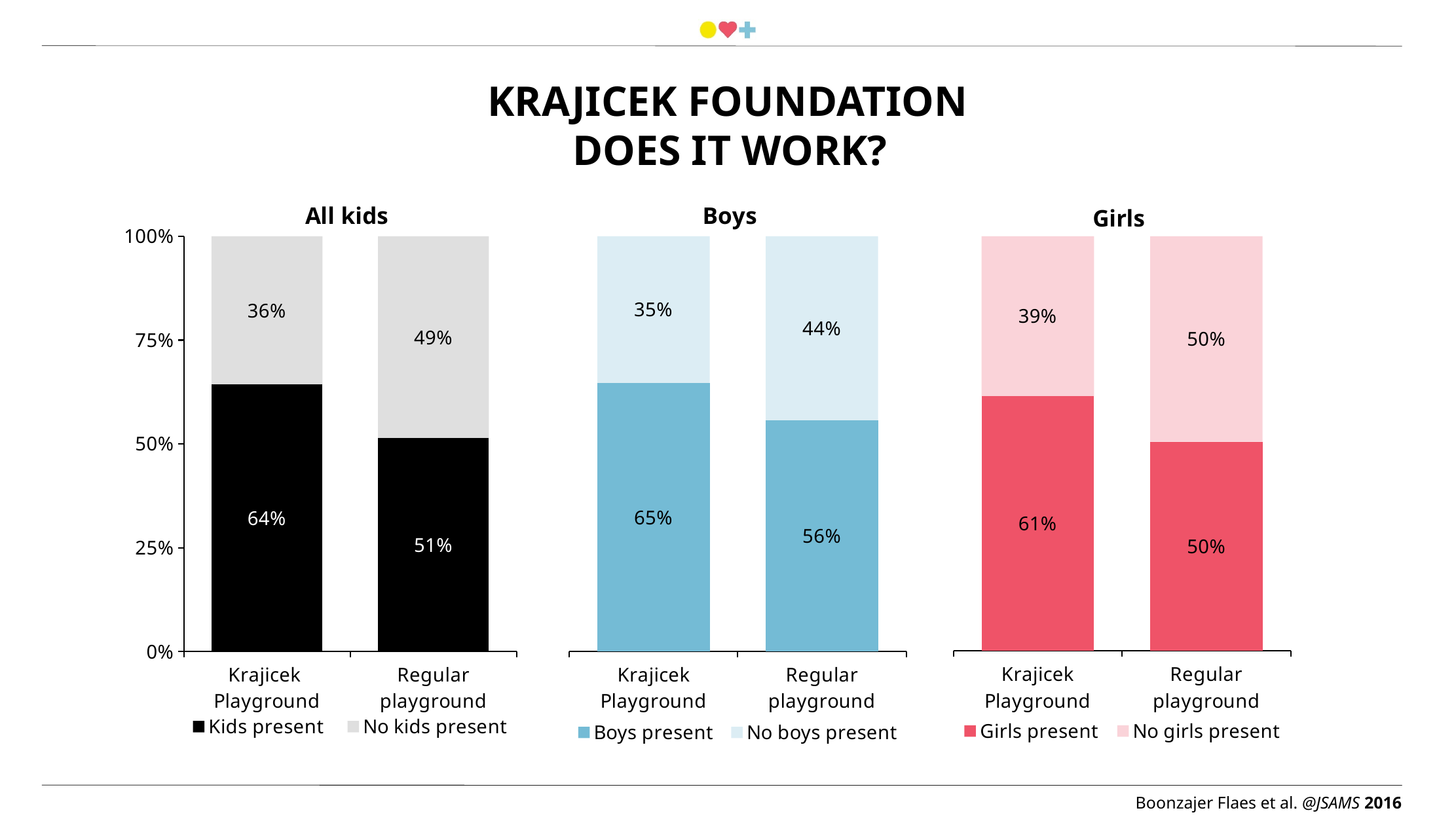
What kind of chart is the 'All kids' chart? Stacked bar chart In the 'All kids' chart, what is the difference between 'Kids present' at the Krajicek Playground and at the Regular playground? 13% In the 'Boys' chart, what is the difference between 'No boys present' at the Regular playground and at the Krajicek Playground? 9% In the 'All kids' chart, what percentage is shown for 'Kids present' at the Krajicek Playground? 64% In the 'All kids' chart, what is the total of the stacked bar for the Regular playground? 100% In the 'Girls' chart, is the 'Girls present' value for the Regular playground greater or less than 'Girls present' for the Krajicek Playground? less In the 'Boys' chart, which playground has the higher 'Boys present' value? Krajicek Playground How many series does the legend of the 'Girls' chart list? 2 In the 'Boys' chart, what percentage is shown for 'No boys present' at the Regular playground? 44% In the 'Girls' chart, what percentage is shown for 'Girls present' at the Krajicek Playground? 61% How many playground categories are shown in the 'Boys' chart? 2 What colour represents 'Girls present' in the 'Girls' chart? Red